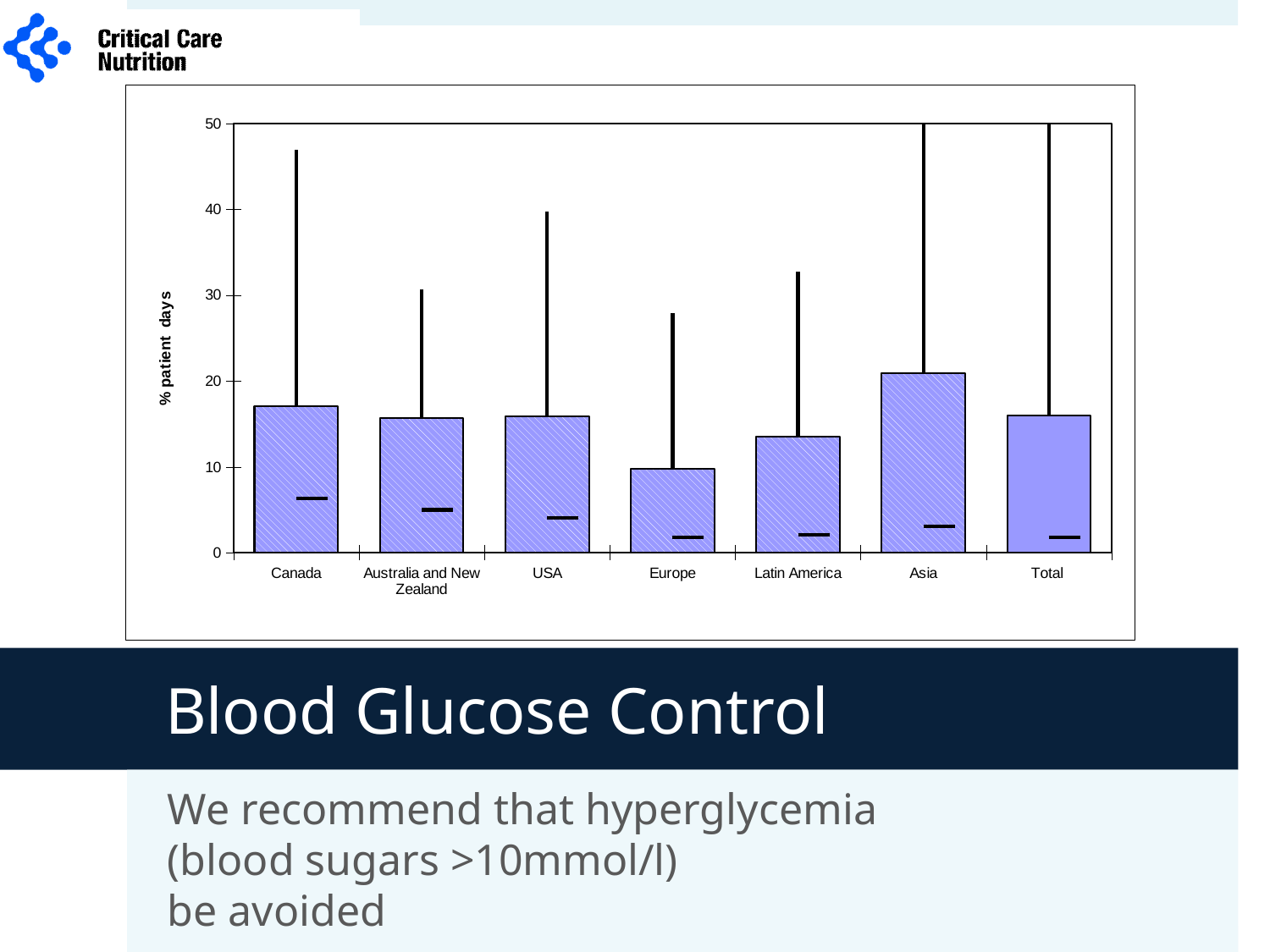
How many categories are shown on the x axis of the chart? 7 Is the value for Asia greater or less than 30? less Is the value for Europe greater or less than 20? less Which is larger, the bar for Asia or the bar for Canada? Asia Is the value for Canada greater or less than 10? greater What is the label on the y axis of the chart? % patient days Which is larger, the bar for Canada or the bar for Europe? Canada Which category has the lowest bar in the chart? Europe What kind of chart is shown on the slide? bar chart Which category has the highest bar in the chart? Asia